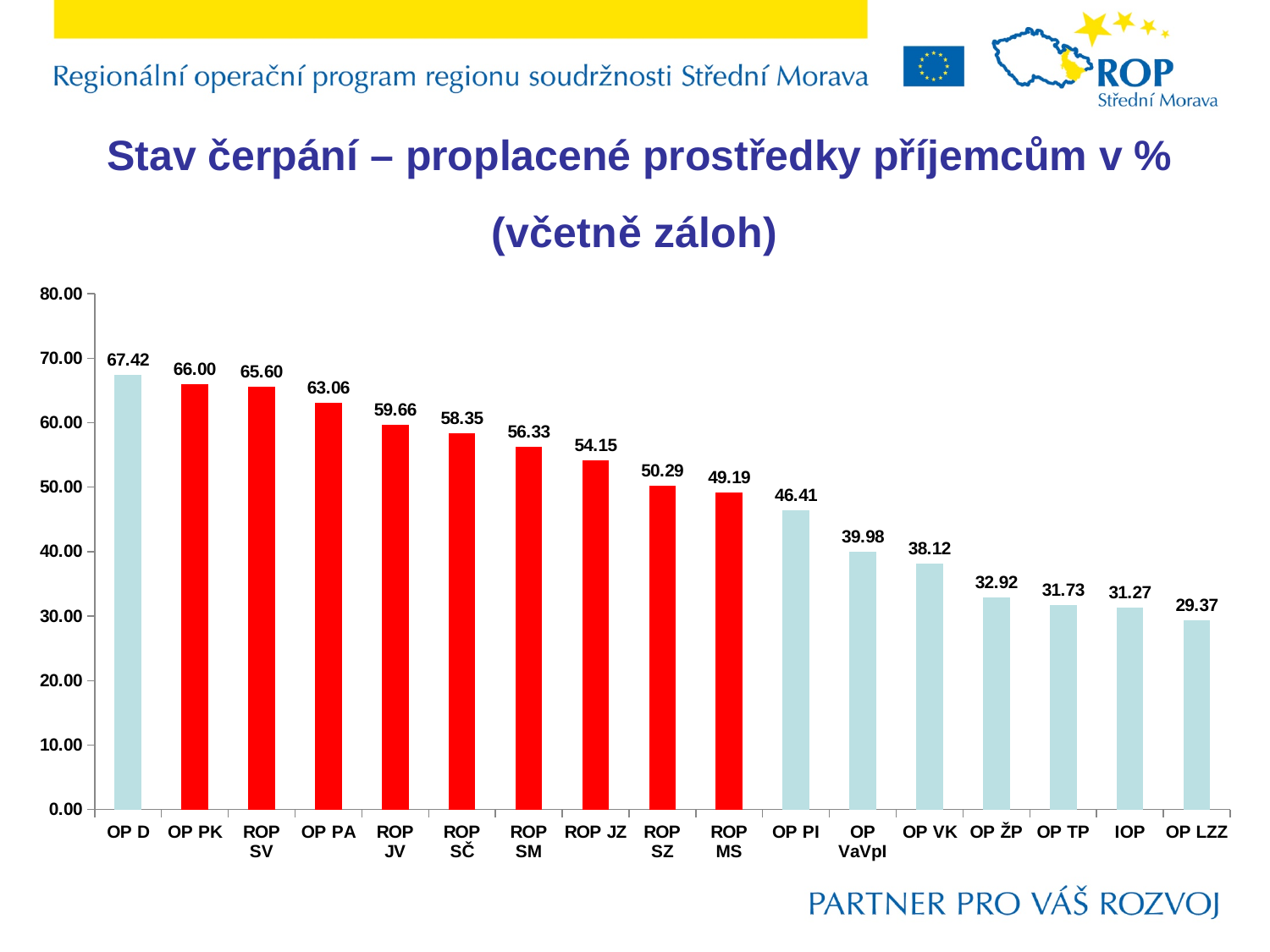
What is the difference between the values for OP D and OP LZZ? 38.05 What is the value for OP D? 67.42 What is the difference between the values for OP PK and ROP SV? 0.40 Which is larger, the value for ROP JZ or the value for OP PI? ROP JZ What is the value for ROP SM? 56.33 Do the values rise or fall from left to right along the x axis? fall What kind of chart is shown on the slide? bar chart Which category has the highest value? OP D How many categories are shown on the x axis? 17 Is the value for OP VK greater or less than 40.00? less What is the value for OP VaVpI? 39.98 Which category has the lowest value? OP LZZ